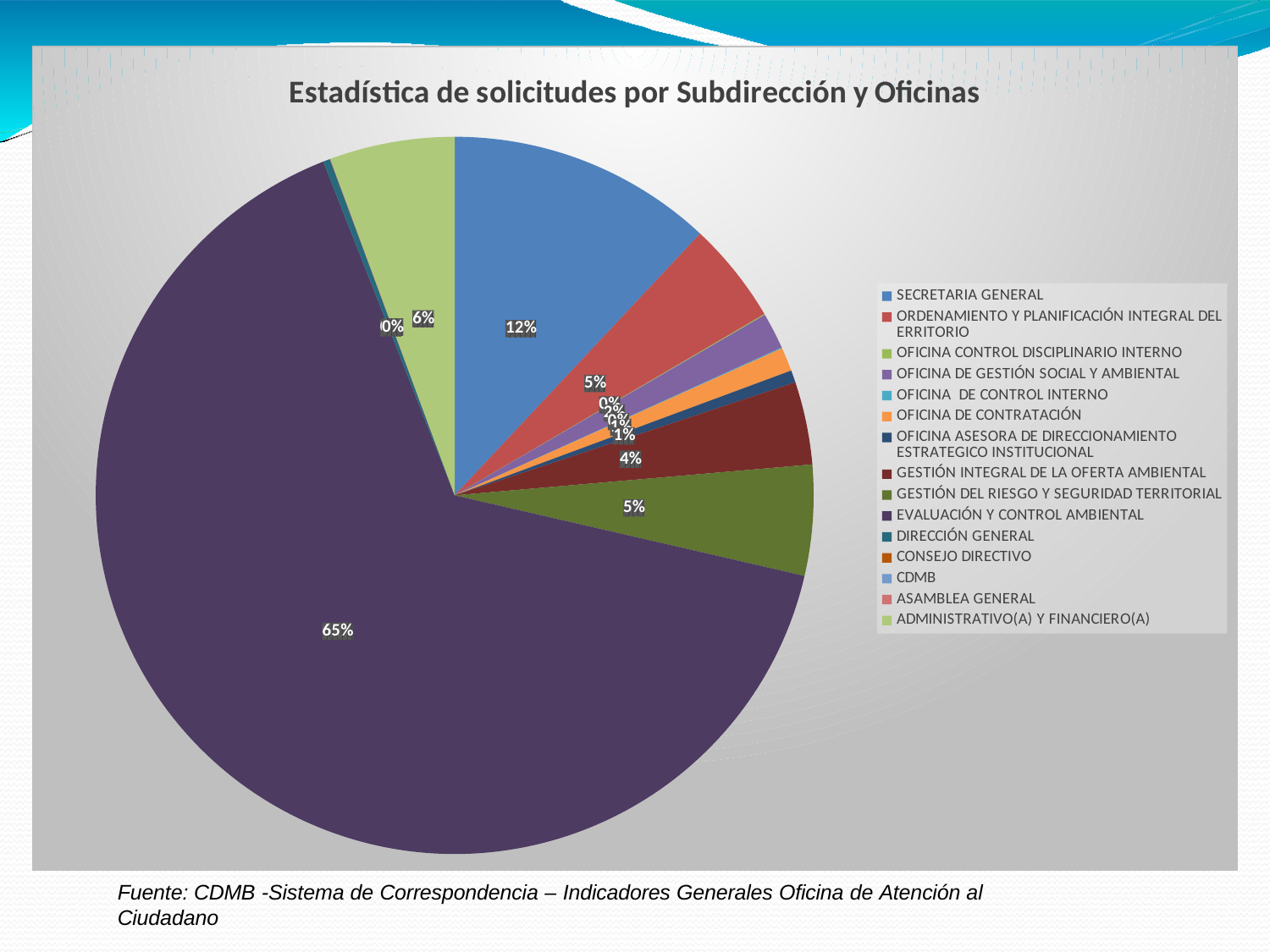
What is the title of the chart? Estadística de solicitudes por Subdirección y Oficinas What percentage of the pie corresponds to ADMINISTRATIVO(A) Y FINANCIERO(A)? 6% What percentage of the pie corresponds to GESTIÓN DEL RIESGO Y SEGURIDAD TERRITORIAL? 5% What kind of chart is shown on the slide? Pie chart By how many percentage points does the share of EVALUACIÓN Y CONTROL AMBIENTAL exceed that of SECRETARIA GENERAL? 53 percentage points Which has a larger share, GESTIÓN DEL RIESGO Y SEGURIDAD TERRITORIAL or GESTIÓN INTEGRAL DE LA OFERTA AMBIENTAL? GESTIÓN DEL RIESGO Y SEGURIDAD TERRITORIAL What percentage of the pie corresponds to SECRETARIA GENERAL? 12% What percentage of the pie corresponds to EVALUACIÓN Y CONTROL AMBIENTAL? 65% Which has a larger share, SECRETARIA GENERAL or ADMINISTRATIVO(A) Y FINANCIERO(A)? SECRETARIA GENERAL How many entries does the legend list? 15 Which category has the largest share of the pie? EVALUACIÓN Y CONTROL AMBIENTAL What percentage of the pie corresponds to GESTIÓN INTEGRAL DE LA OFERTA AMBIENTAL? 4%